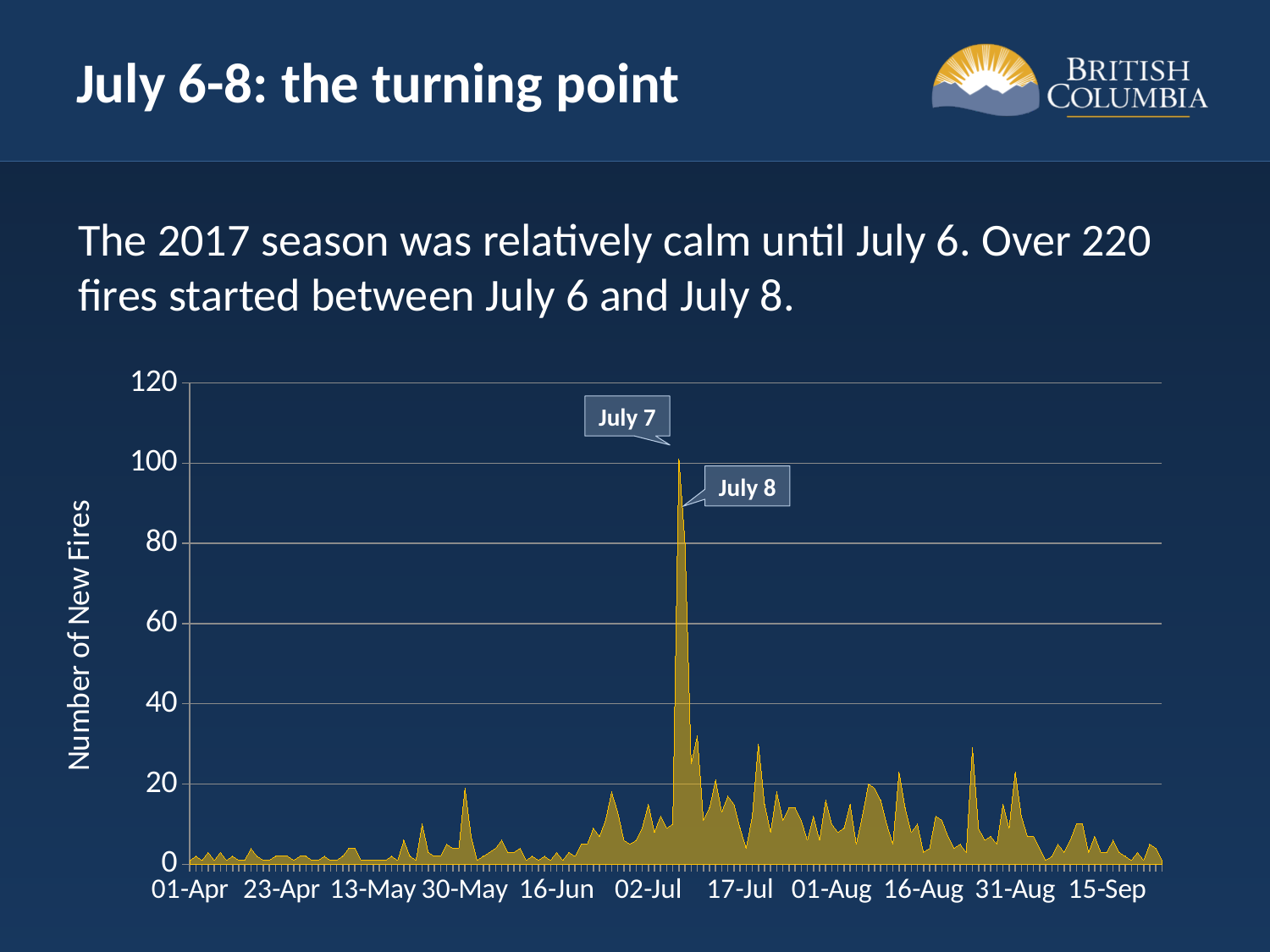
Which date is annotated as the highest peak in the chart? July 7 Is the value for July 8 greater or less than 100? less Is the value for 15-Sep greater or less than 40? less Is the value for 01-Apr greater or less than 20? less What is the highest value shown on the vertical axis? 120 What kind of chart is shown on the slide? Area chart How many date labels are shown along the horizontal axis? 11 Which has the larger number of new fires, July 7 or July 8? July 7 What is the label on the vertical axis of the chart? Number of New Fires Which two dates are called out with labels on the chart? July 7 and July 8